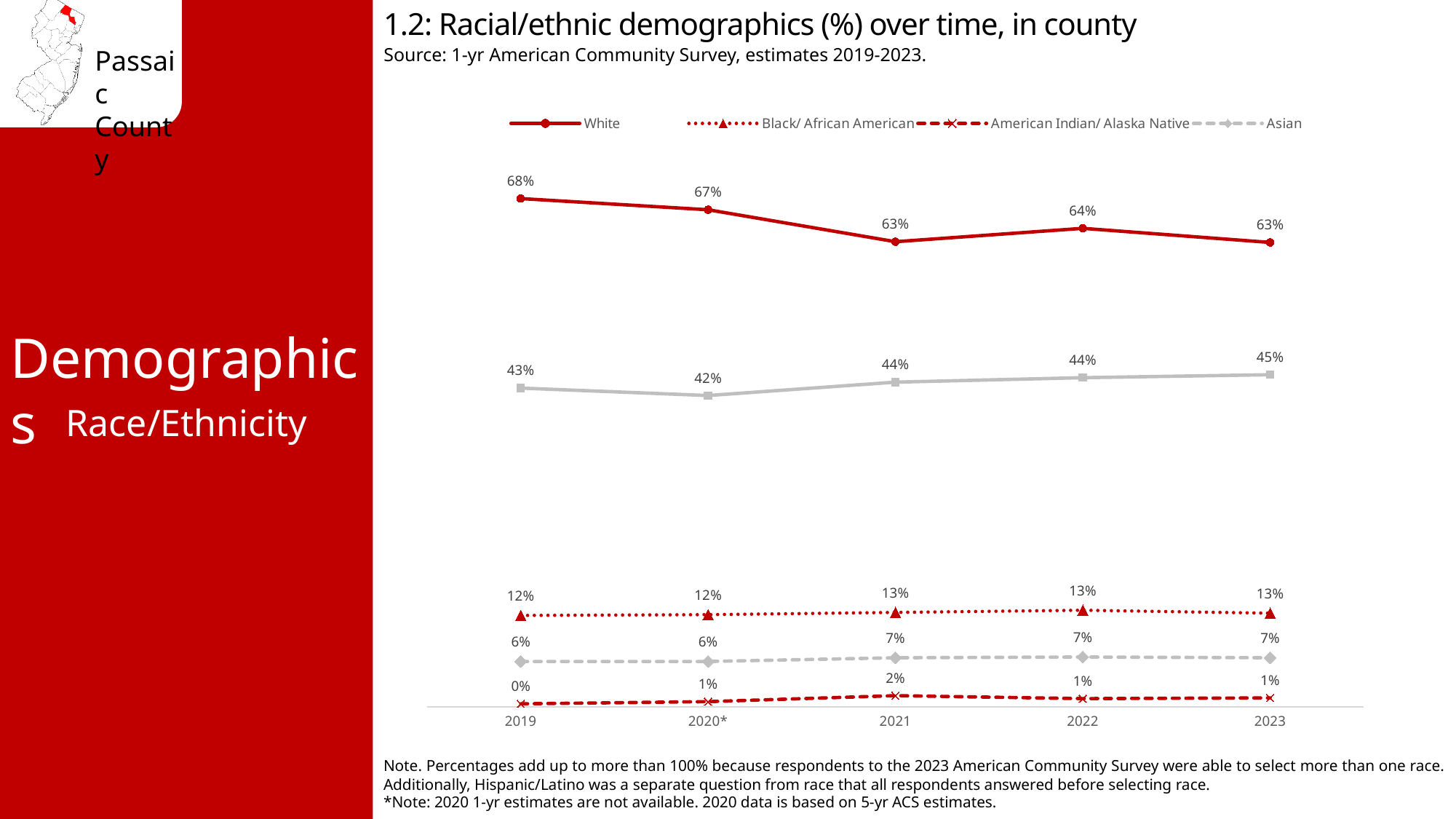
What was the White percentage in 2019? 68% In which year was the White percentage highest? 2019 What type of chart is shown on the slide? line chart What was the Asian percentage in 2021? 7% What was the Black/ African American percentage in 2023? 13% What was the American Indian/ Alaska Native percentage in 2021? 2% How many years are plotted on the x axis? 5 In which year was the American Indian/ Alaska Native percentage lowest? 2019 Does the White percentage generally rise or fall from 2019 to 2023? fall By how many percentage points did the White percentage change from 2019 to 2023? 5 percentage points (68% to 63%) Which was larger in 2022, the Black/ African American percentage or the Asian percentage? Black/ African American How many series does the legend list? 4